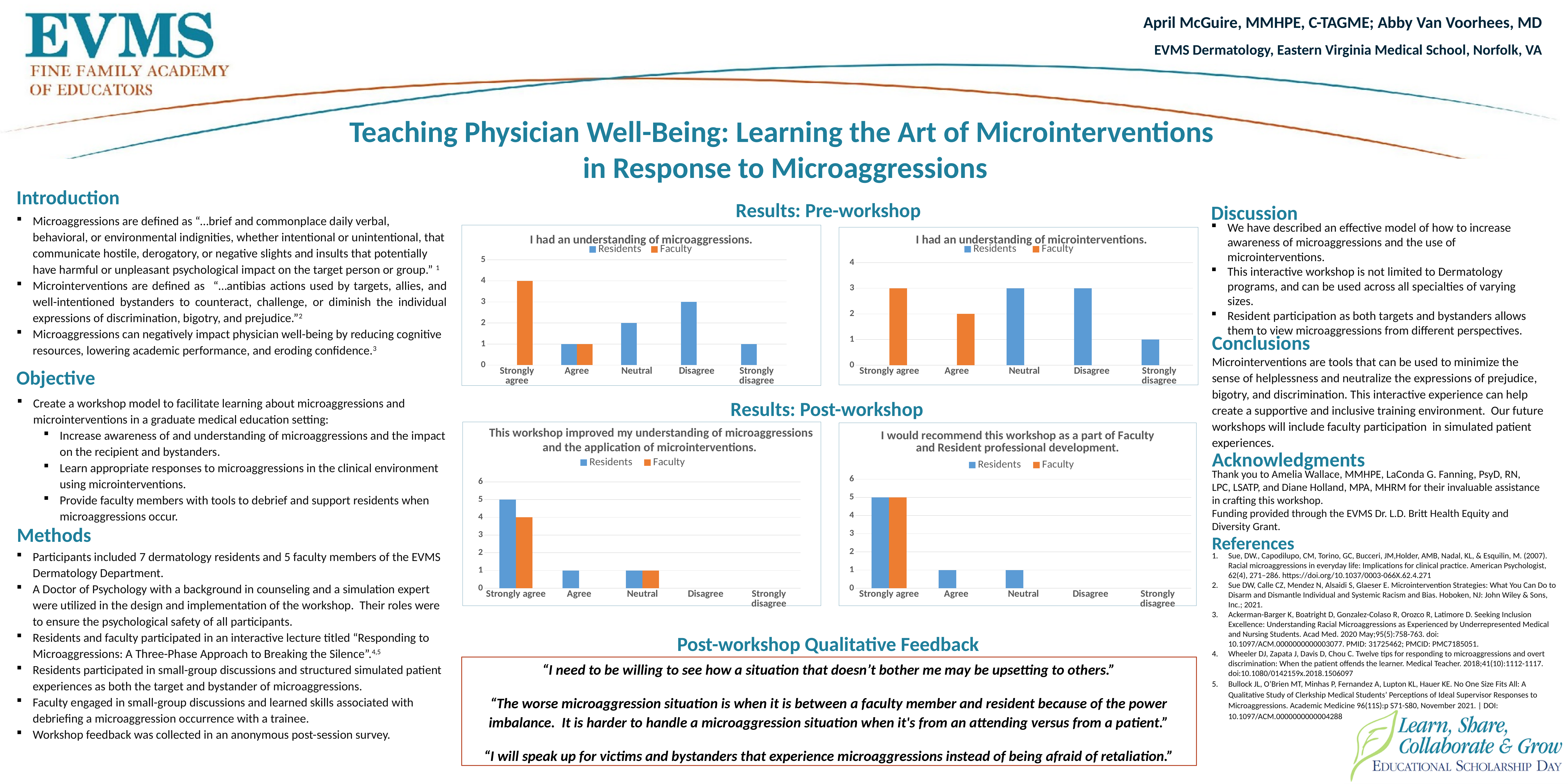
In the chart titled "I had an understanding of microaggressions.", what is the Faculty value for Strongly agree? 4 In the chart titled "I had an understanding of microinterventions.", what is the Faculty value for Agree? 2 In the chart titled "I would recommend this workshop as a part of Faculty and Resident professional development.", how many categories are shown on the x axis? 5 In the chart titled "I had an understanding of microaggressions.", what colour represents the Faculty series? Orange In the chart titled "I had an understanding of microinterventions.", what is the difference between the Residents value for Neutral and the Residents value for Strongly disagree? 2 In the chart titled "I had an understanding of microinterventions.", how many series does the legend list? 2 In the chart titled "This workshop improved my understanding of microaggressions and the application of microinterventions.", what is the Residents value for Strongly agree? 5 In the chart titled "I would recommend this workshop as a part of Faculty and Resident professional development.", what is the Faculty value for Strongly agree? 5 In the chart titled "I had an understanding of microaggressions.", which category has the highest Residents value? Disagree What type of chart is the chart titled "I would recommend this workshop as a part of Faculty and Resident professional development."? Bar chart In the chart titled "This workshop improved my understanding of microaggressions and the application of microinterventions.", which is larger for Strongly agree, Residents or Faculty? Residents In the chart titled "I had an understanding of microaggressions.", what is the Residents value for Disagree? 3